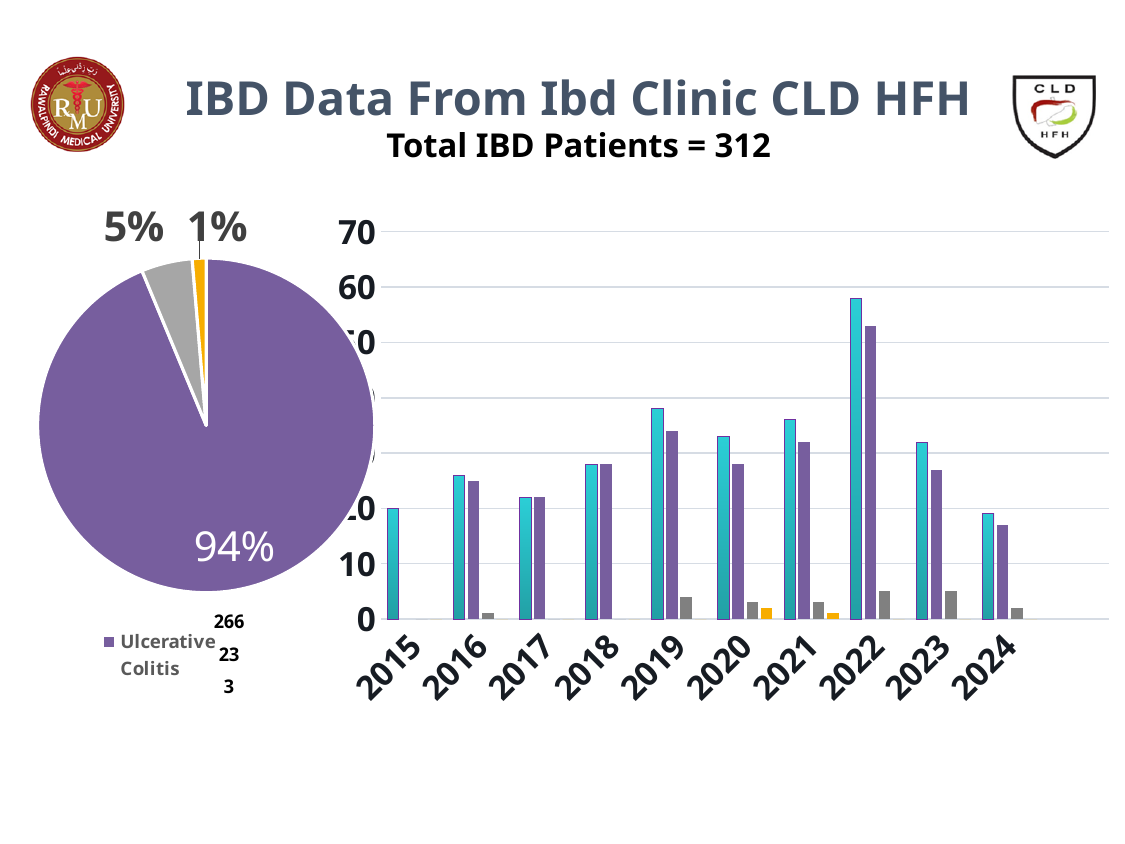
How many years are shown on the x axis of the bar chart? 10 In the pie chart, which slice is the largest? Ulcerative Colitis In the pie chart, what percentage is shown for the orange slice? 1% In the bar chart, is the cyan bar for 2022 greater or less than 50? greater In the bar chart, is the cyan bar larger for 2022 or for 2023? 2022 In the bar chart, which year has the tallest cyan bar? 2022 In the bar chart, is the cyan bar for 2017 greater or less than 30? less What kind of chart is on the left side of the slide? pie chart What kind of chart is on the right side of the slide? bar chart How many slices does the pie chart have? 3 In the pie chart, what share is labelled for the Ulcerative Colitis slice? 94% In the pie chart, what percentage is shown for the grey slice? 5%